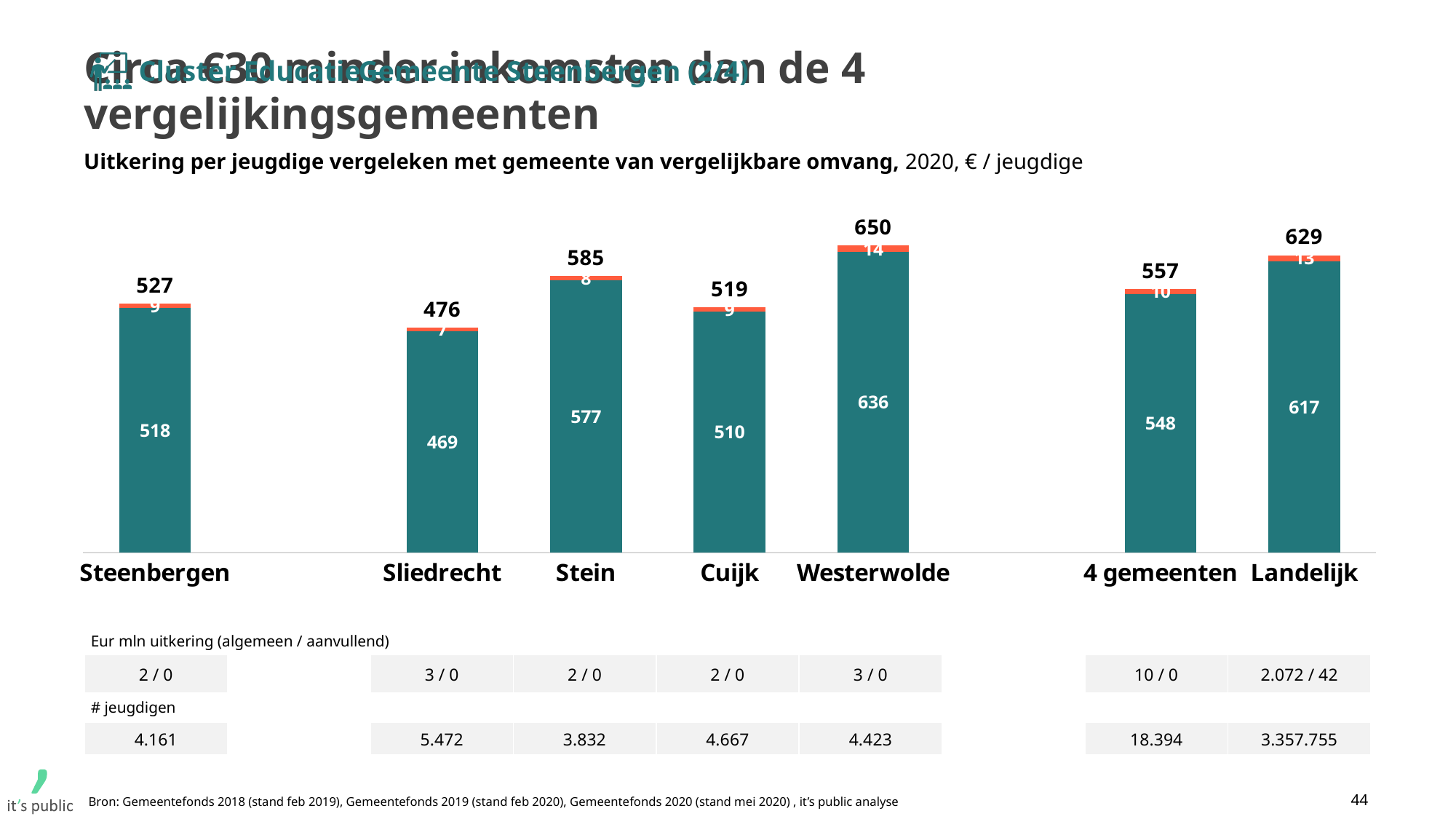
What unit is stated in the chart subtitle for the plotted values? € / jeugdige Which has a larger total value, Stein or Landelijk? Landelijk What is the total value shown above the bar for 4 gemeenten? 557 What is the value of the teal segment of the Cuijk bar? 510 What is the difference between the total for Landelijk and the total for 4 gemeenten? 72 What is the difference between the total for Westerwolde and the total for Steenbergen? 123 Which category has the highest total value? Westerwolde What is the total value shown above the bar for Steenbergen? 527 What kind of chart is shown on the slide? Bar chart What is the value of the large teal segment of the Westerwolde bar? 636 How many categories are shown on the x axis of the chart? 7 Which category has the lowest total value? Sliedrecht